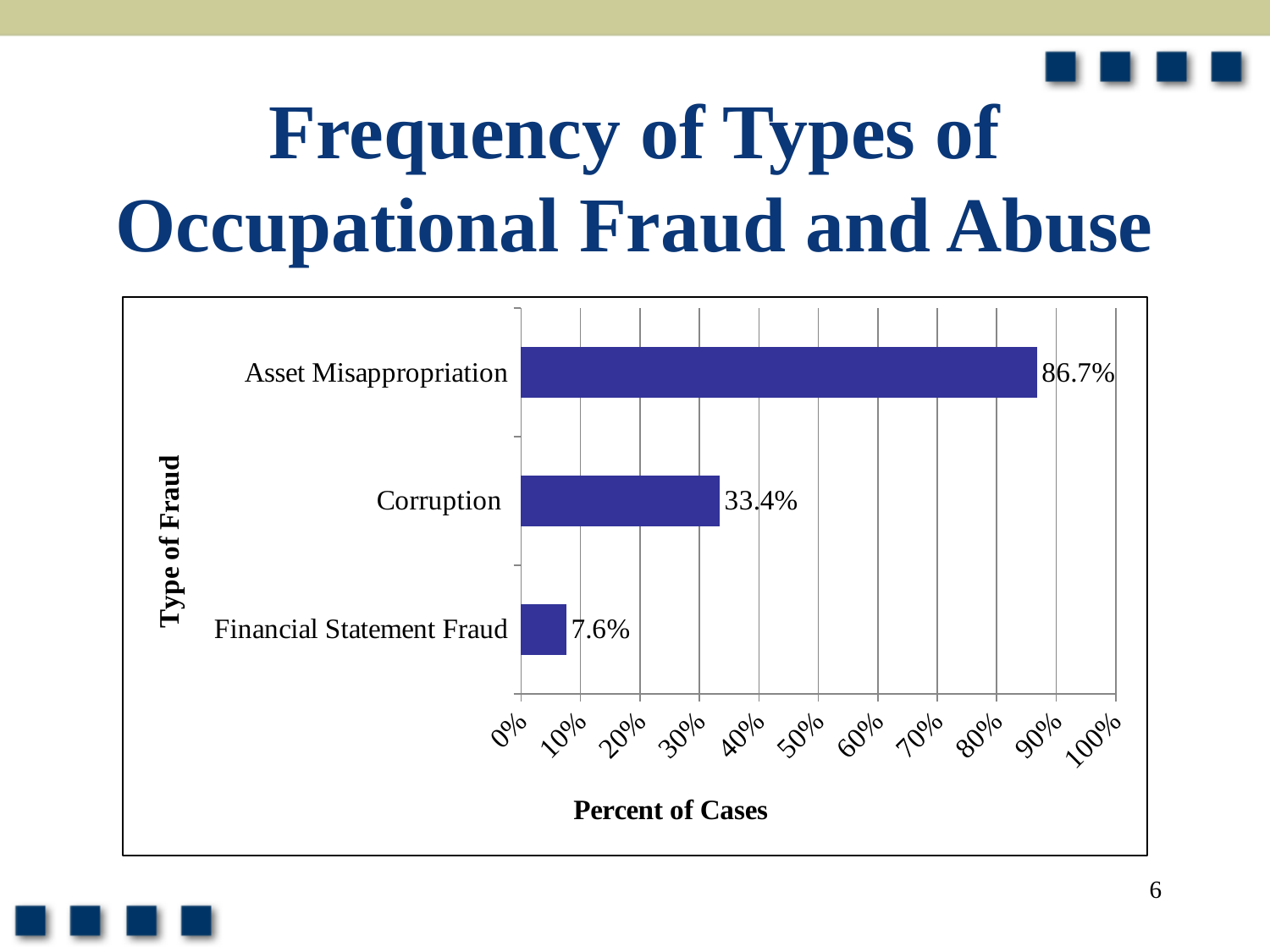
What is the difference in percent of cases between Asset Misappropriation and Corruption? 53.3% How many types of fraud are shown in the chart? 3 Which type of fraud has the highest percent of cases? Asset Misappropriation What kind of chart is shown on the slide? Bar chart Which has a higher percent of cases, Corruption or Financial Statement Fraud? Corruption What is the percent of cases for Asset Misappropriation? 86.7% What is the difference in percent of cases between Corruption and Financial Statement Fraud? 25.8% Is the value for Corruption greater or less than 30%? greater What is the label of the horizontal axis of the chart? Percent of Cases What is the percent of cases for Financial Statement Fraud? 7.6% Which type of fraud has the lowest percent of cases? Financial Statement Fraud What is the percent of cases for Corruption? 33.4%